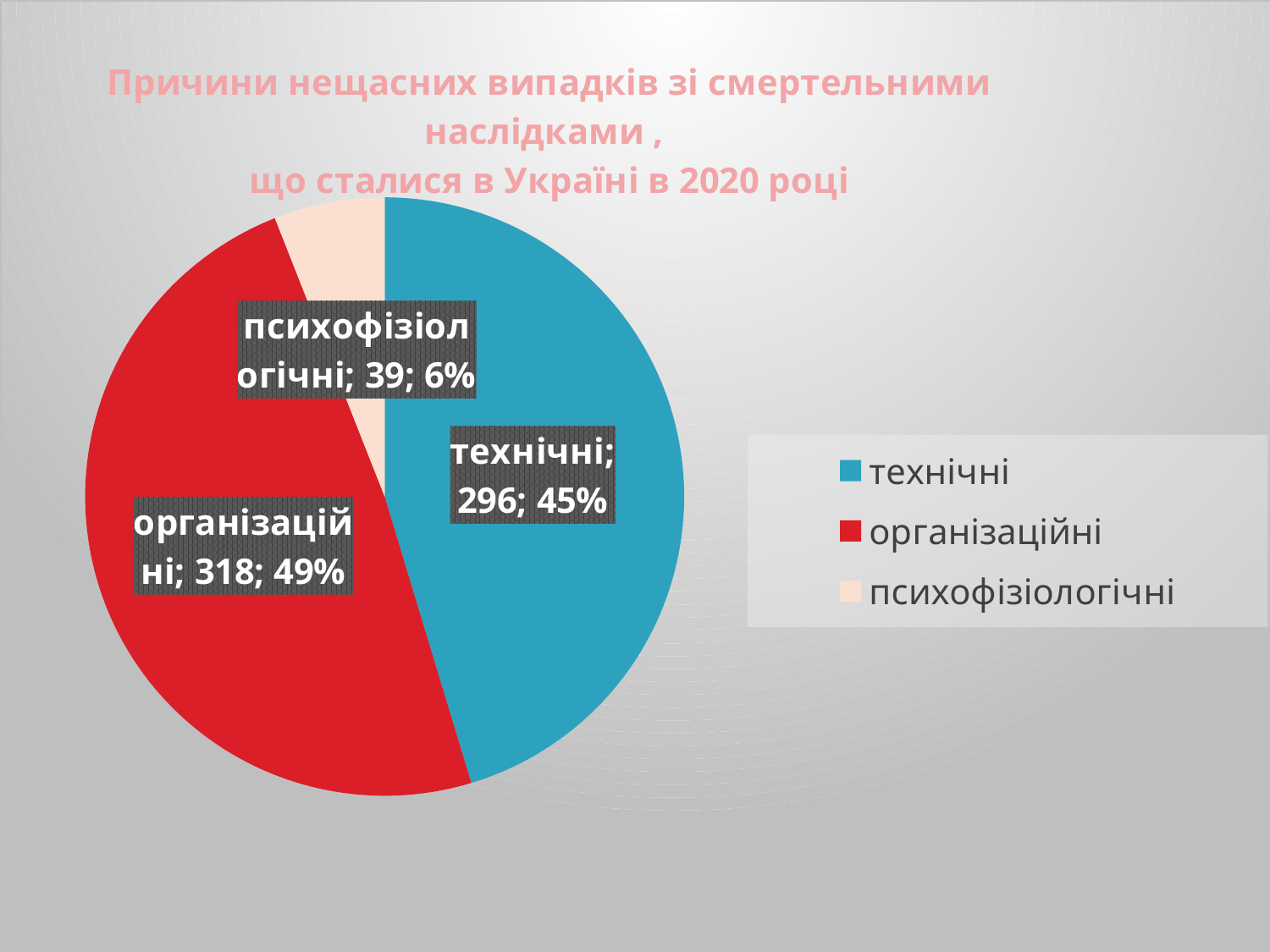
What is the value for технічні? 296 What is the value for психофізіологічні? 39 How many categories does the pie chart have? 3 What share of the pie does the психофізіологічні slice represent? 6% Which category has the largest value? організаційні Which category has the smallest value? психофізіологічні What share of the pie does the технічні slice represent? 45% What is the difference between the values for організаційні and технічні? 22 What is the value for організаційні? 318 What kind of chart is shown on the slide? pie chart Which colour represents організаційні in the legend? red What share of the pie does the організаційні slice represent? 49%